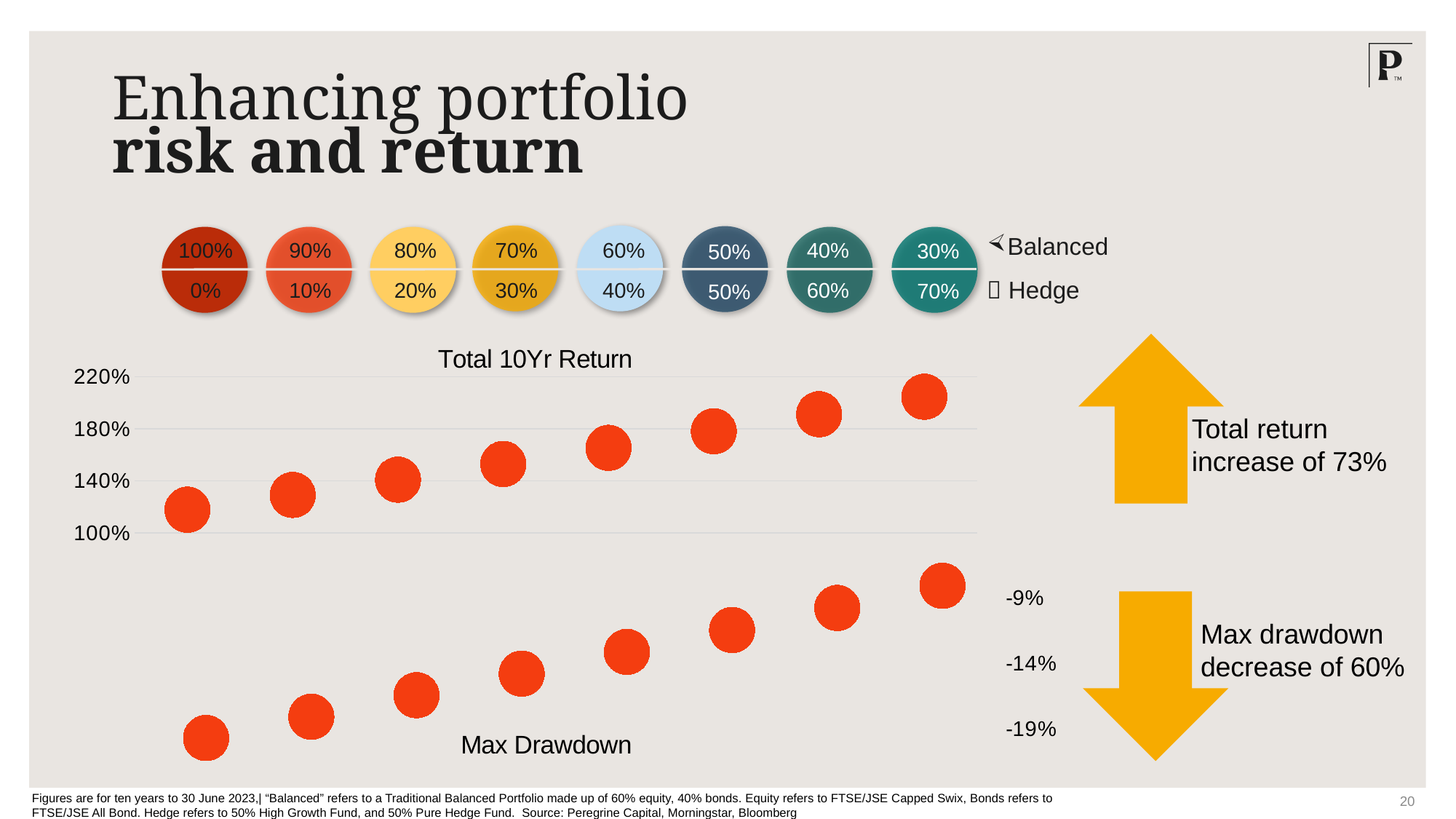
In the Total 10Yr Return chart, which portfolio mix has the highest total return? 30% Balanced / 70% Hedge In the Total 10Yr Return chart, which portfolio mix has the lowest total return? 100% Balanced / 0% Hedge In the Total 10Yr Return chart, which has the larger total return: the 90% Balanced / 10% Hedge portfolio or the 40% Balanced / 60% Hedge portfolio? 40% Balanced / 60% Hedge In the Total 10Yr Return chart, is the value for the 70% Balanced / 30% Hedge portfolio greater or less than 140%? greater What is the title of the upper chart on the slide? Total 10Yr Return In the Total 10Yr Return chart, do the values rise or fall as the Hedge allocation increases from left to right? Rise In the Total 10Yr Return chart, is the value for the 100% Balanced / 0% Hedge portfolio greater or less than 140%? less How many portfolio points are plotted in the Total 10Yr Return chart? 8 In the Total 10Yr Return chart, is the value for the 60% Balanced / 40% Hedge portfolio greater or less than 180%? less In the Max Drawdown chart, do the points rise or fall from left to right as the Hedge allocation increases? Rise What kind of chart is the Total 10Yr Return chart? Scatter (dot) chart